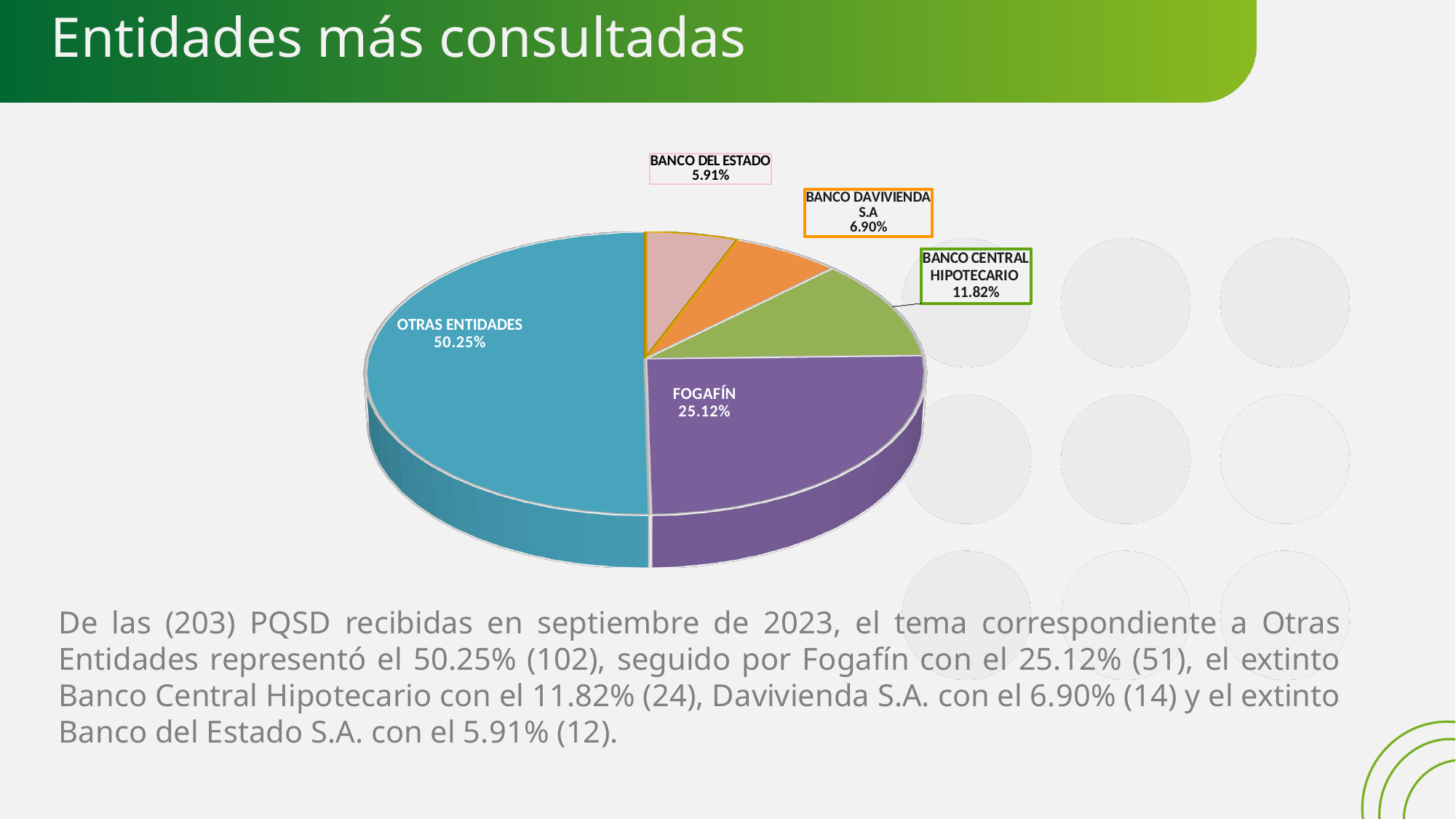
What type of chart is shown on the slide? Pie chart What is the value shown for BANCO CENTRAL HIPOTECARIO? 11.82% What share of the pie does OTRAS ENTIDADES represent? 50.25% Which is larger, the slice for BANCO CENTRAL HIPOTECARIO or the slice for BANCO DAVIVIENDA S.A? BANCO CENTRAL HIPOTECARIO How many categories are shown in the pie chart? 5 Which category has the smallest slice of the pie? BANCO DEL ESTADO What is the value shown for BANCO DAVIVIENDA S.A? 6.90% What is the difference in percentage points between OTRAS ENTIDADES and FOGAFÍN? 25.13 What is the value shown for BANCO DEL ESTADO? 5.91% What is the value shown for FOGAFÍN? 25.12% What colour is the FOGAFÍN slice? Purple Which category has the largest slice of the pie? OTRAS ENTIDADES